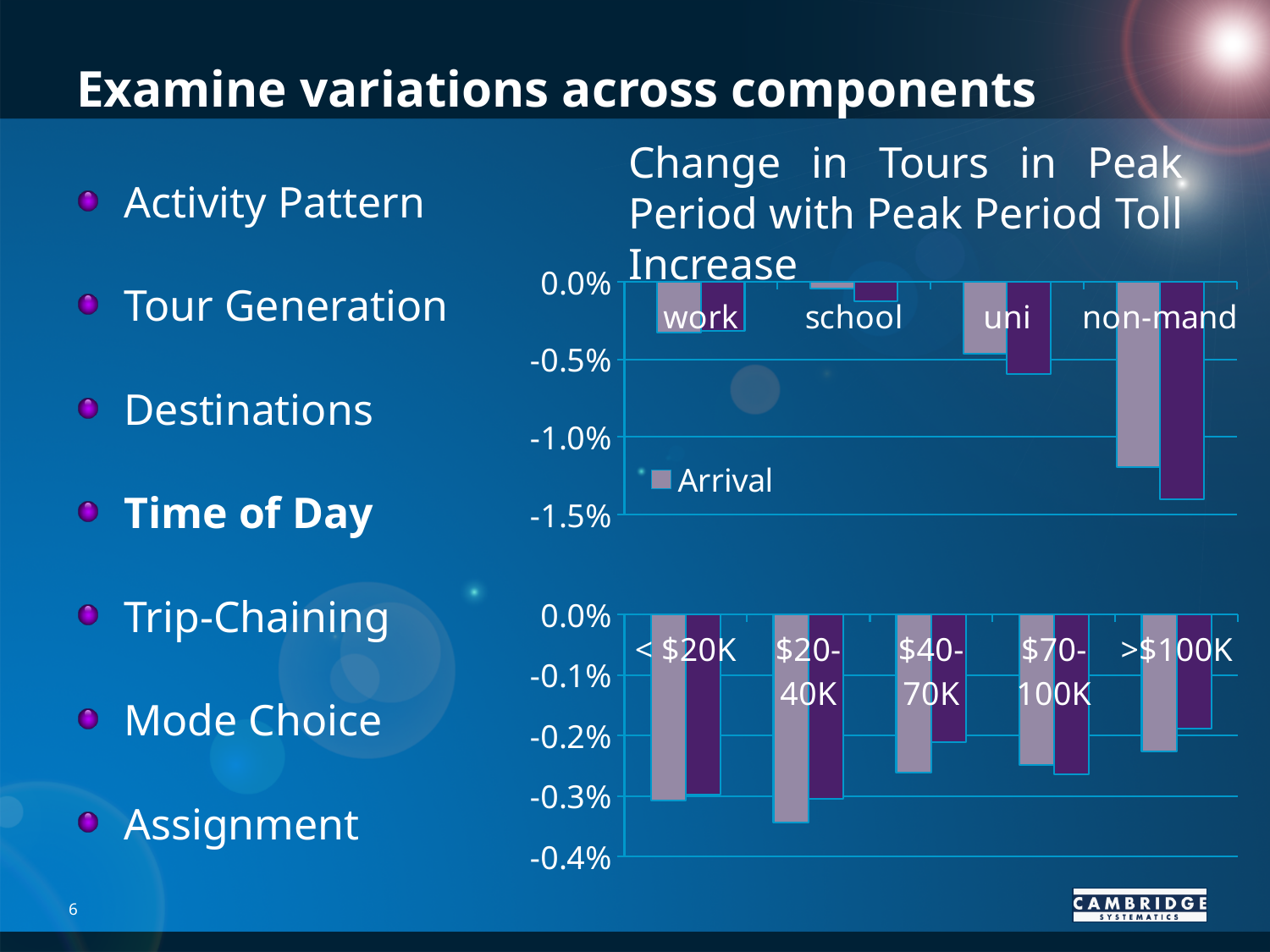
In the bottom chart, is the value of the dark purple bar for >$100K greater or less than -0.2%? greater In the top chart, is the value of the light purple bar for work greater or less than -0.5%? greater In the bottom chart, is the value of the light purple bar for $20-40K greater or less than -0.3%? less In the top chart, which shows a larger decrease in the light purple series: work or uni? uni What legend entry is visible in the top chart? Arrival In the bottom chart, which income category has the largest decrease in the light purple series? $20-40K In the top chart (Change in Tours in Peak Period), which category shows the largest decrease? non-mand What kind of chart is the top chart titled 'Change in Tours in Peak Period with Peak Period Toll Increase'? bar chart How many categories are shown on the x axis of the top chart (Change in Tours in Peak Period)? 4 In the top chart (Change in Tours in Peak Period), which category shows the smallest change? school How many income categories are shown on the x axis of the bottom chart? 5